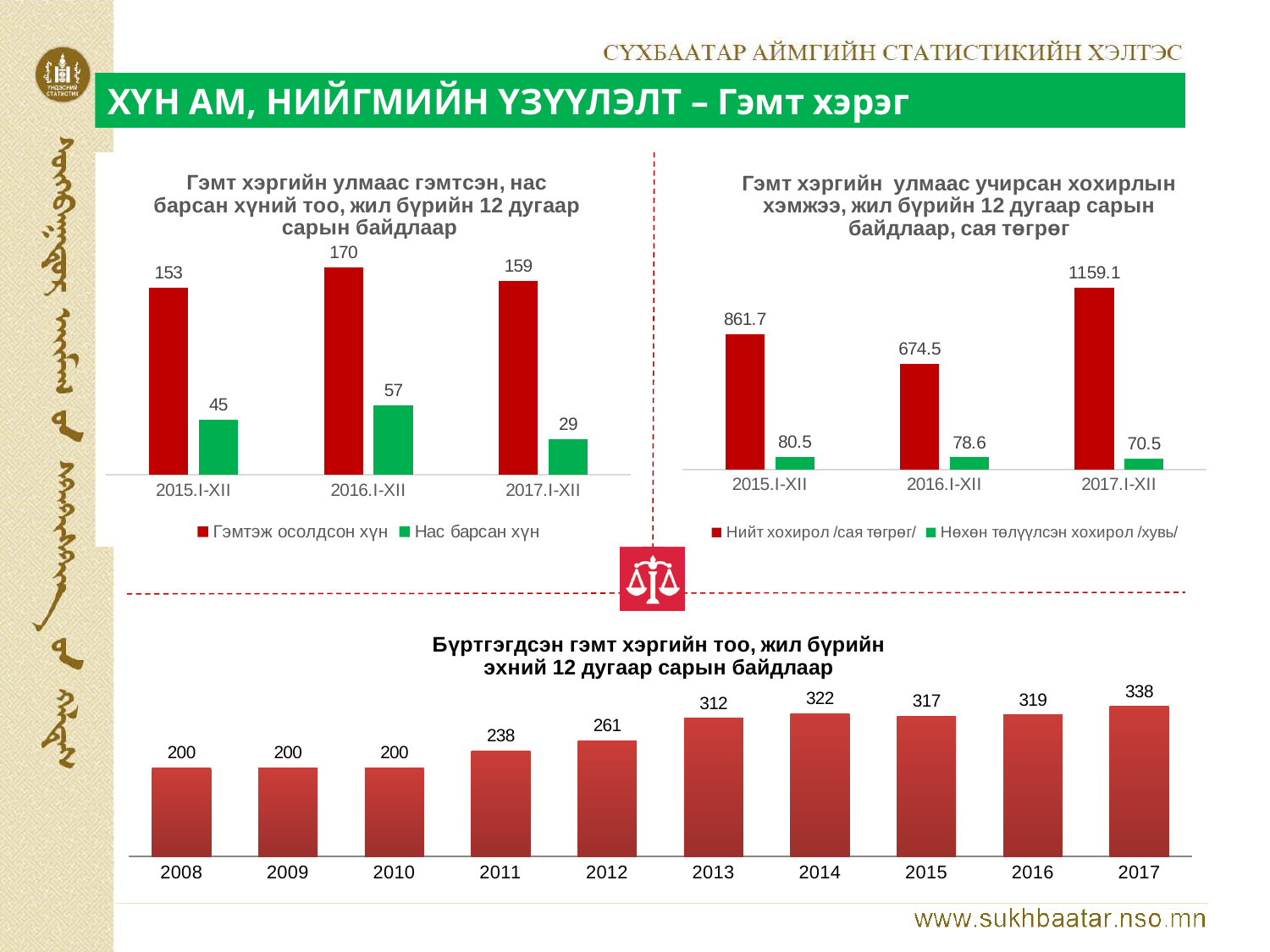
In the bottom chart (Бүртгэгдсэн гэмт хэргийн тоо), what is the difference between the values for 2014 and 2013? 10 In the top-left chart (Гэмт хэргийн улмаас гэмтсэн, нас барсан хүний тоо), what is the value for Гэмтэж осолдсон хүн in 2016.I-XII? 170 In the top-right chart (Гэмт хэргийн улмаас учирсан хохирлын хэмжээ), which is larger: Нөхөн төлүүлсэн хохирол in 2015.I-XII or in 2017.I-XII? 2015.I-XII In the bottom chart (Бүртгэгдсэн гэмт хэргийн тоо), how many years are shown on the x axis? 10 In the bottom chart (Бүртгэгдсэн гэмт хэргийн тоо), what is the value for 2017? 338 In the top-left chart (Гэмт хэргийн улмаас гэмтсэн, нас барсан хүний тоо), which period has the lowest value for Нас барсан хүн? 2017.I-XII In the top-right chart (Гэмт хэргийн улмаас учирсан хохирлын хэмжээ), what is the value for Нийт хохирол in 2017.I-XII? 1159.1 In the bottom chart (Бүртгэгдсэн гэмт хэргийн тоо), which year has the lowest value? 2008, 2009 and 2010 (all 200) In the bottom chart (Бүртгэгдсэн гэмт хэргийн тоо), do the values generally rise or fall from 2008 to 2017? rise What kind of chart is the bottom chart (Бүртгэгдсэн гэмт хэргийн тоо)? bar chart In the top-right chart (Гэмт хэргийн улмаас учирсан хохирлын хэмжээ), which period has the highest value for Нийт хохирол? 2017.I-XII In the top-left chart (Гэмт хэргийн улмаас гэмтсэн, нас барсан хүний тоо), how many series does the legend list? 2